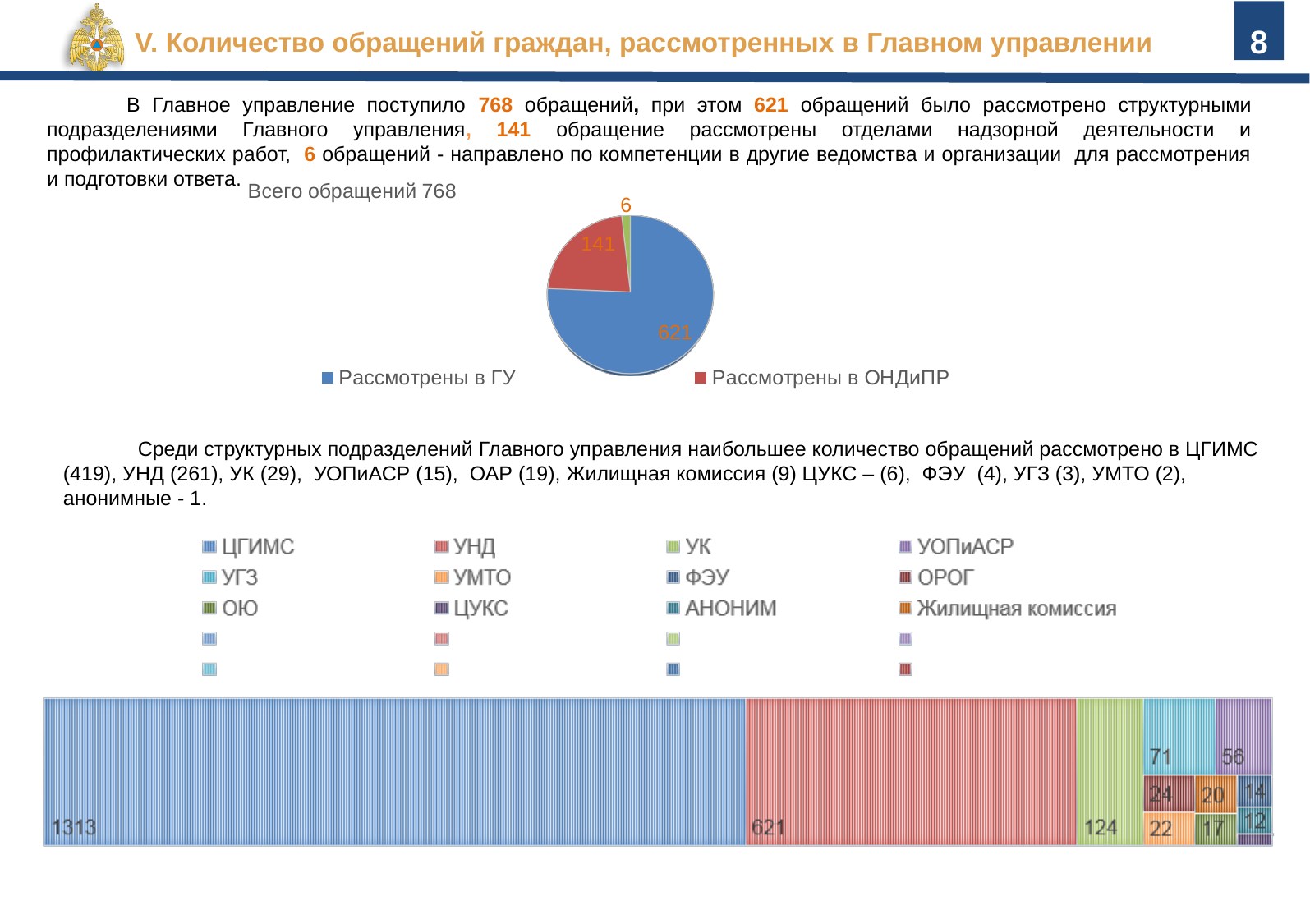
What is the title of the pie chart at the top of the slide? Всего обращений 768 In the pie chart titled 'Всего обращений 768', what is the sum of the three slice values (621, 141 and 6)? 768 In the pie chart titled 'Всего обращений 768', how many slices does the pie have? 3 In the chart at the bottom of the slide, what is the difference between the two largest labelled values, 1313 and 621? 692 In the pie chart titled 'Всего обращений 768', which category has the largest slice? Рассмотрены в ГУ In the pie chart titled 'Всего обращений 768', what is the difference between the values for 'Рассмотрены в ГУ' and 'Рассмотрены в ОНДиПР'? 480 In the pie chart titled 'Всего обращений 768', what value is shown for 'Рассмотрены в ОНДиПР'? 141 How many named entries does the legend of the chart at the bottom of the slide list? 12 In the chart at the bottom of the slide, what is the largest value shown? 1313 In the pie chart titled 'Всего обращений 768', which is larger: the slice labelled 141 or the slice labelled 6? 141 What kind of chart is the upper chart titled 'Всего обращений 768'? Pie chart In the pie chart titled 'Всего обращений 768', what value is shown for 'Рассмотрены в ГУ'? 621